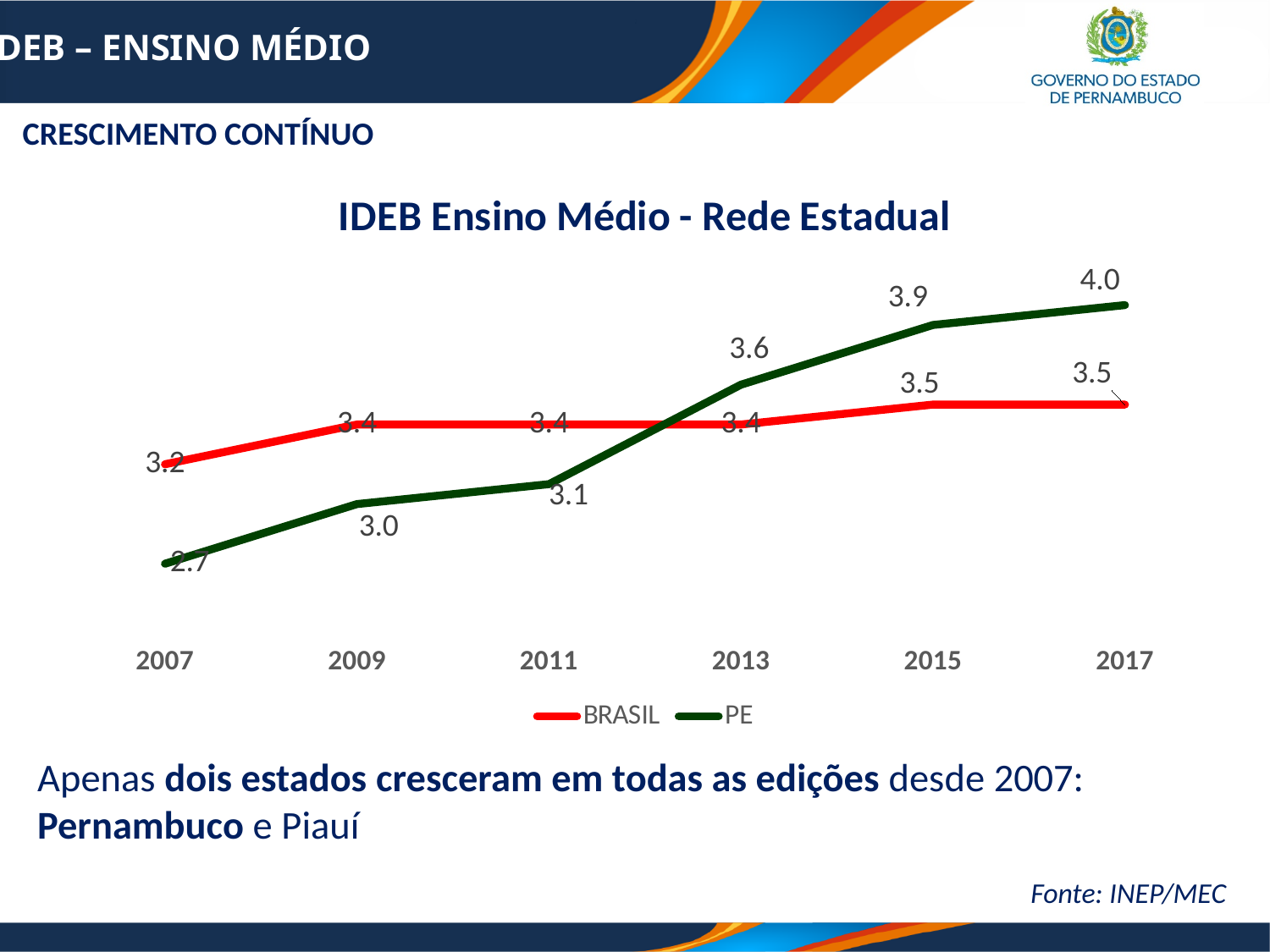
What type of chart is shown on the slide? line chart Which series has the higher value in 2009, BRASIL or PE? BRASIL What is the difference between PE and BRASIL in 2017? 0.5 What is the value for BRASIL in 2017? 3.5 In which year is the BRASIL value lowest? 2007 Does the PE line rise or fall from 2007 to 2017? rise What is the value for PE in 2013? 3.6 How many series does the legend list? 2 How many years are shown on the x axis? 6 What is the value for PE in 2007? 2.7 What is the title of the chart? IDEB Ensino Médio - Rede Estadual In which year does PE reach its highest value? 2017